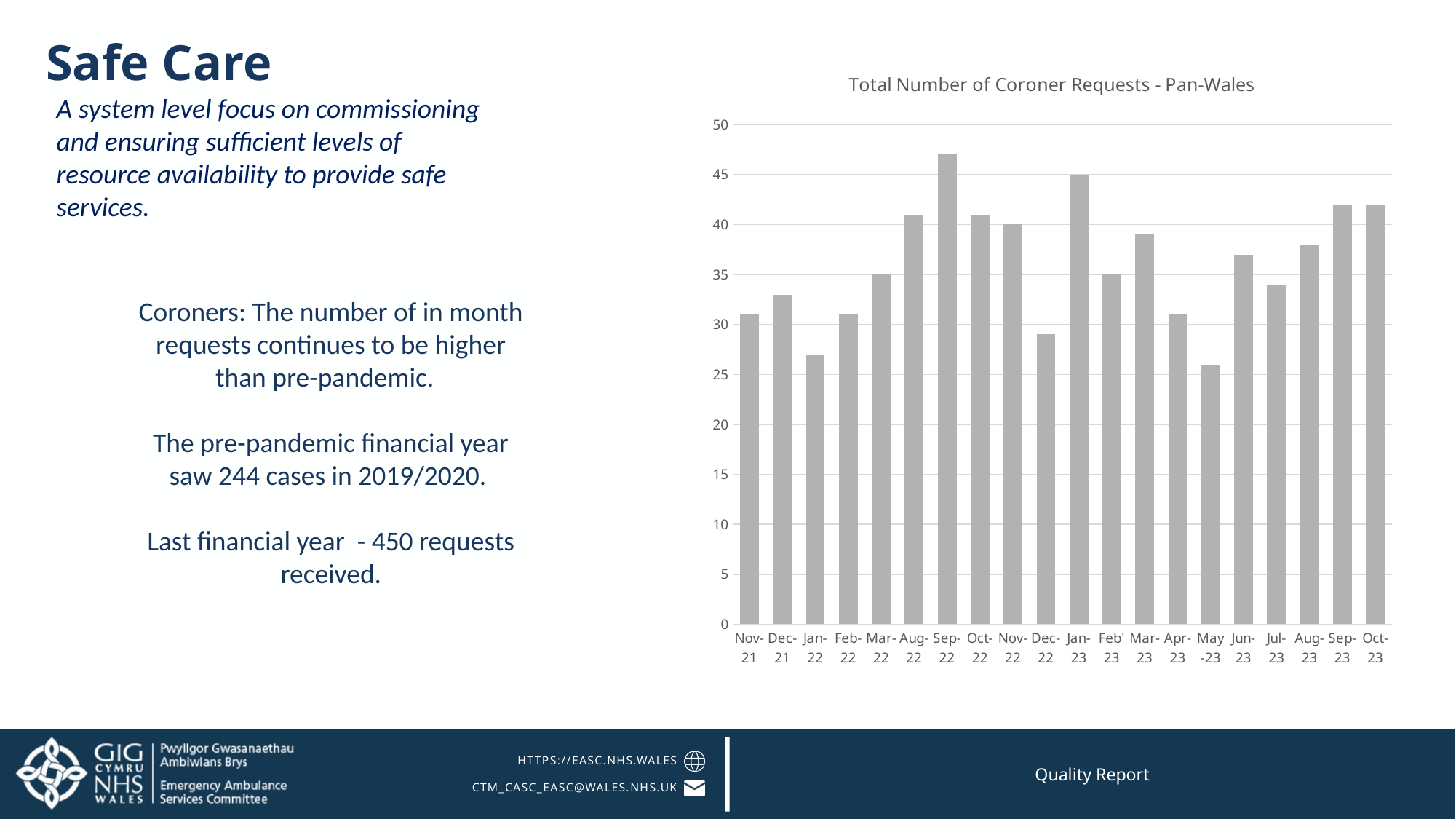
Which is larger, the value for Sep-22 or the value for Jan-23? Sep-22 Which month has the highest number of coroner requests? Sep-22 Is the value for Jan-22 greater or less than 30? less How many months are plotted on the x axis of the chart? 20 Do the values rise or fall from Jan-22 to Sep-22? rise What kind of chart is shown on the slide? bar chart What is the title of the chart? Total Number of Coroner Requests - Pan-Wales Which is larger, the value for Dec-21 or the value for Jan-22? Dec-21 Is the value for Sep-22 greater or less than 45? greater Which is larger, the value for Aug-23 or the value for Jul-23? Aug-23 Is the value for Oct-23 greater or less than 40? greater